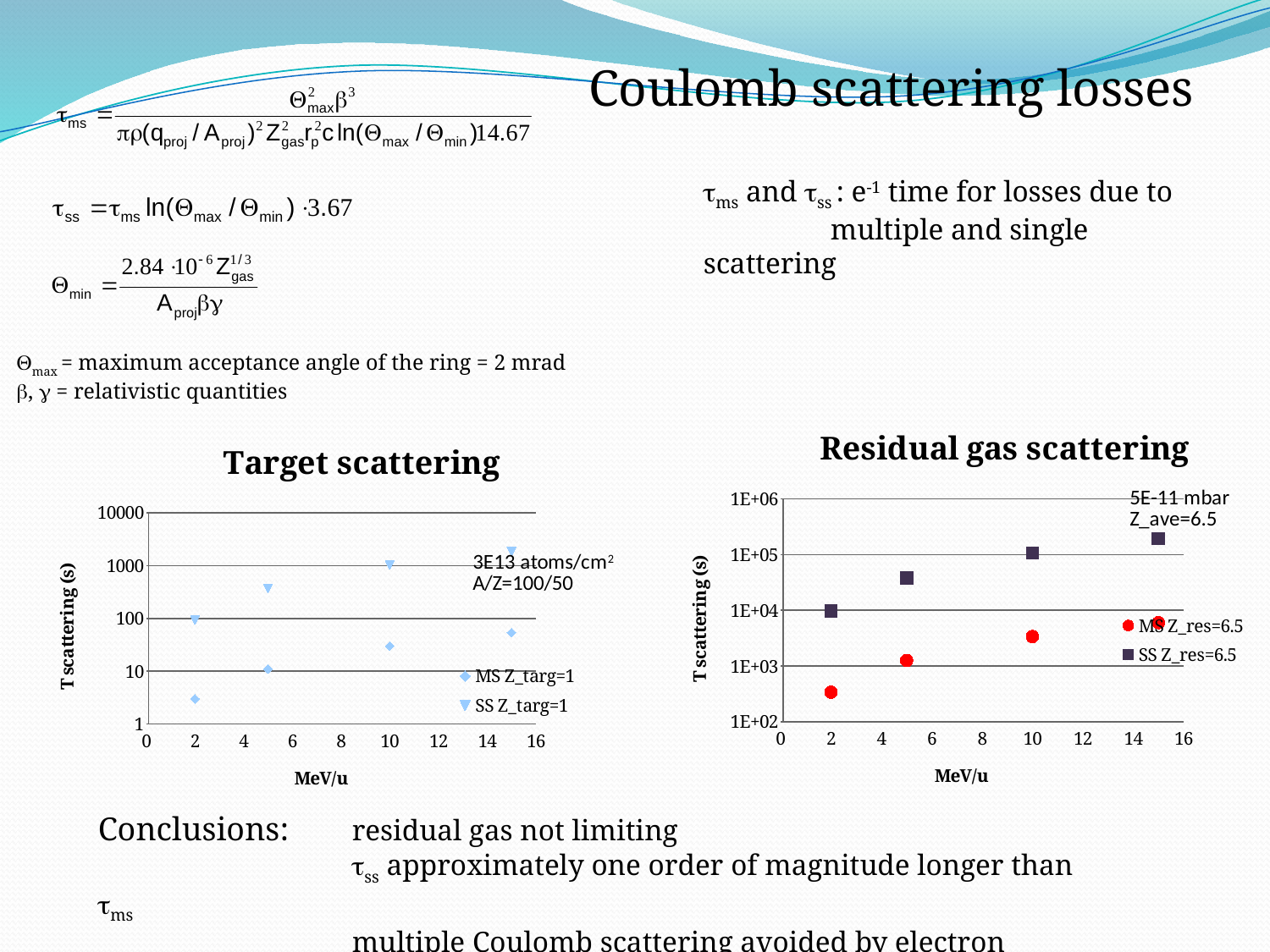
In the "Residual gas scattering" chart, do the SS Z_res=6.5 values rise or fall as MeV/u increases? rise What is the x-axis label of the "Residual gas scattering" chart? MeV/u In the "Residual gas scattering" chart, is the MS Z_res=6.5 value at 2 MeV/u greater or less than 1E+03? less In the "Target scattering" chart, is the SS Z_targ=1 value at 15 MeV/u greater or less than 1000? greater What kind of chart is the "Target scattering" chart? scatter chart In the "Target scattering" chart, is the MS Z_targ=1 value at 2 MeV/u greater or less than 10? less How many series does the legend of the "Residual gas scattering" chart list? 2 In the "Target scattering" chart, how many data points are plotted for the SS Z_targ=1 series? 4 In the "Target scattering" chart, do the MS Z_targ=1 values rise or fall as MeV/u increases? rise In the "Target scattering" chart, at which MeV/u value is the SS Z_targ=1 series lowest? 2 In the "Residual gas scattering" chart, which series has the larger value at 10 MeV/u, MS Z_res=6.5 or SS Z_res=6.5? SS Z_res=6.5